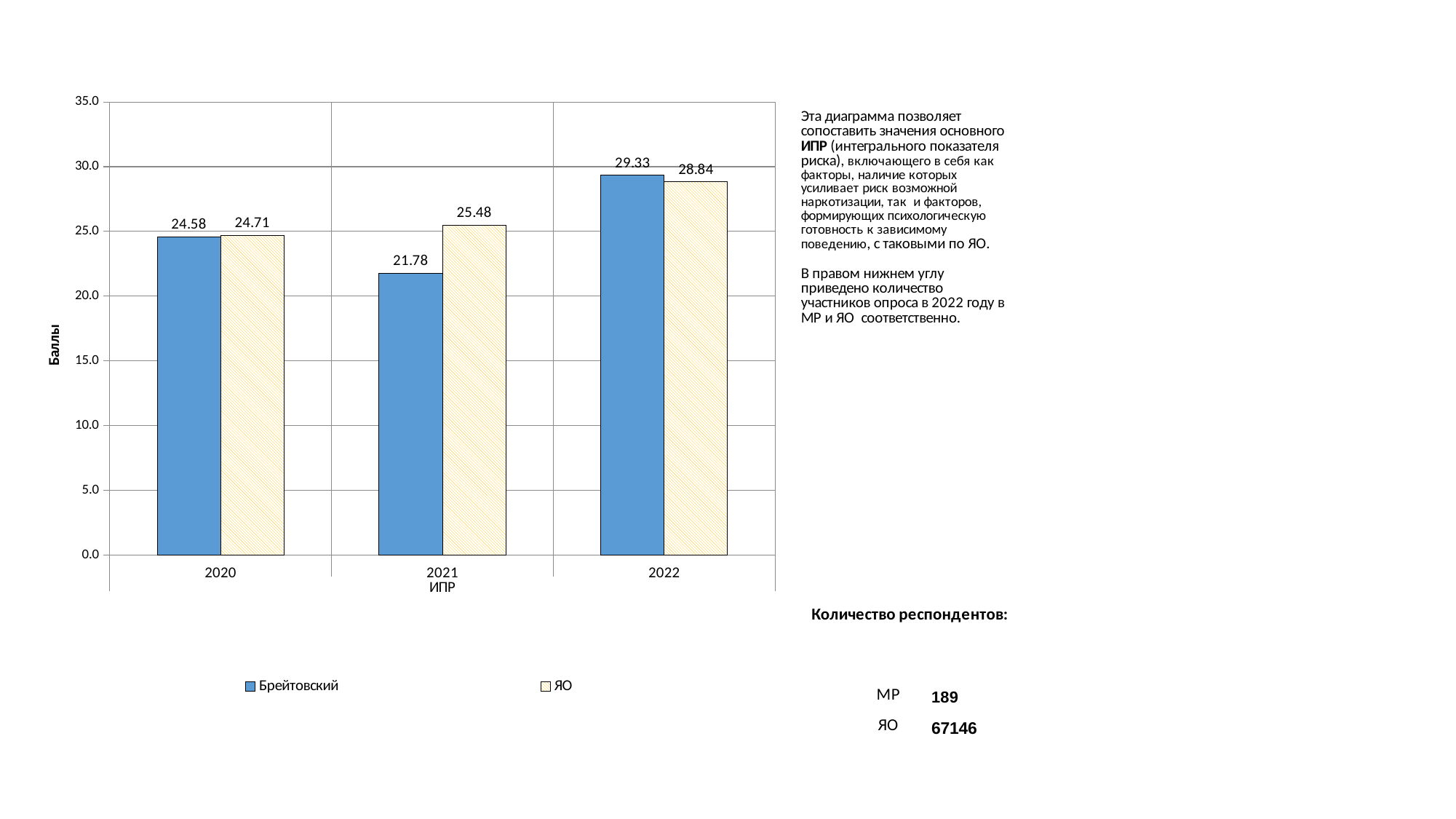
What is the value for ЯО in 2020? 24.71 In which year is the Брейтовский value highest? 2022 In which year is the Брейтовский value lowest? 2021 Is the value for Брейтовский in 2020 greater or less than 25.0? less What is the value for ЯО in 2022? 28.84 What is the difference between the ЯО and Брейтовский values in 2021? 3.70 What kind of chart is shown on the slide? bar chart How many years are shown on the x axis? 3 Which is larger in 2022, Брейтовский or ЯО? Брейтовский What is the value for Брейтовский in 2021? 21.78 What is the label of the vertical axis? Баллы How many series does the legend list? 2